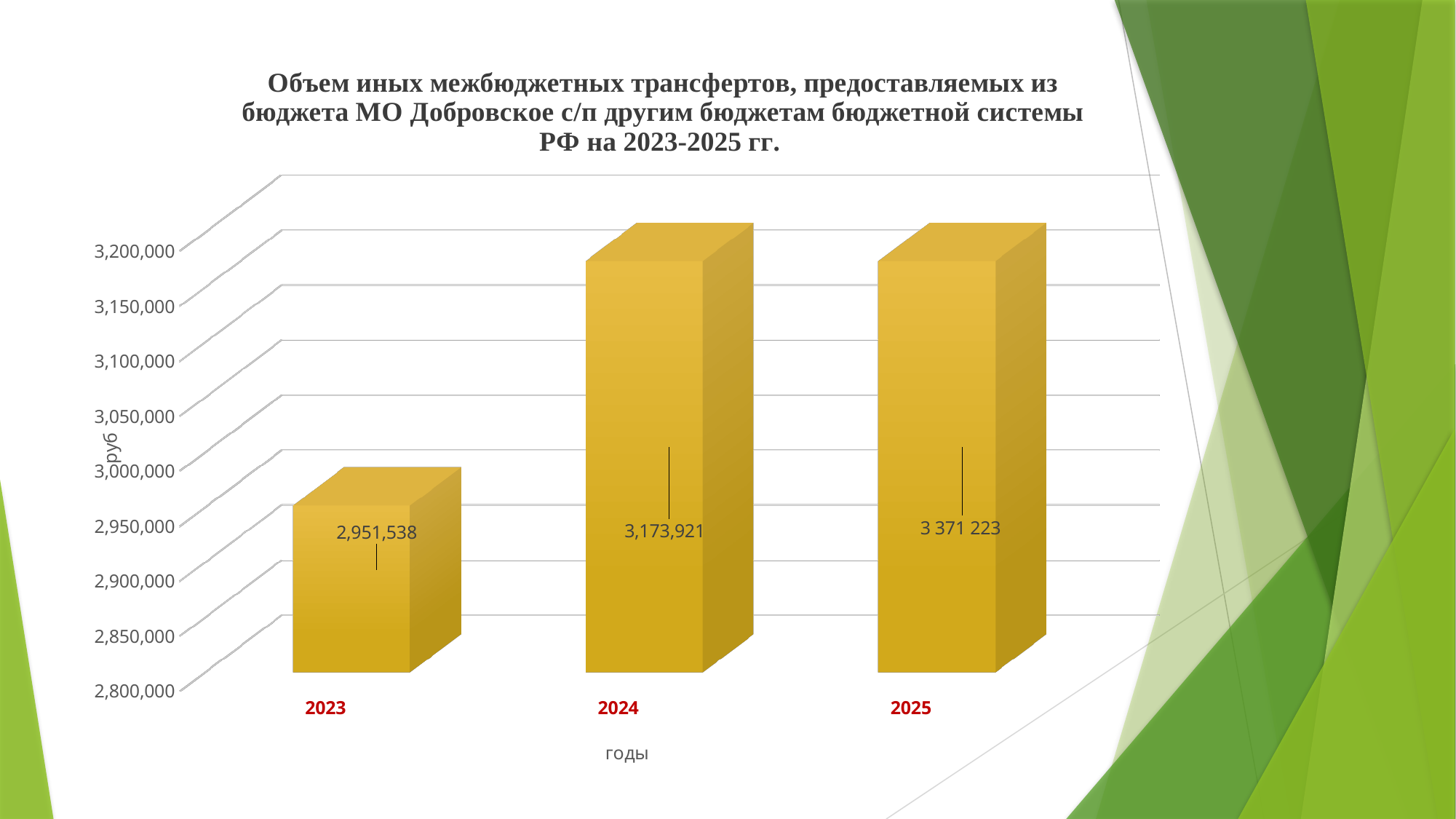
What is the value for 2025? 3 371 223 Is the value for 2024 greater or less than 3,150,000? greater How many years are shown on the chart? 3 What is the difference between the values for 2024 and 2023? 222,383 What kind of chart is shown on the slide? bar chart Which is larger, the value for 2023 or the value for 2024? 2024 What is the value for 2023? 2,951,538 Which year has the lowest value? 2023 What is the value for 2024? 3,173,921 What is the label on the vertical axis? руб Is the value for 2023 greater or less than 3,000,000? less Do the values rise or fall from 2023 to 2025? rise